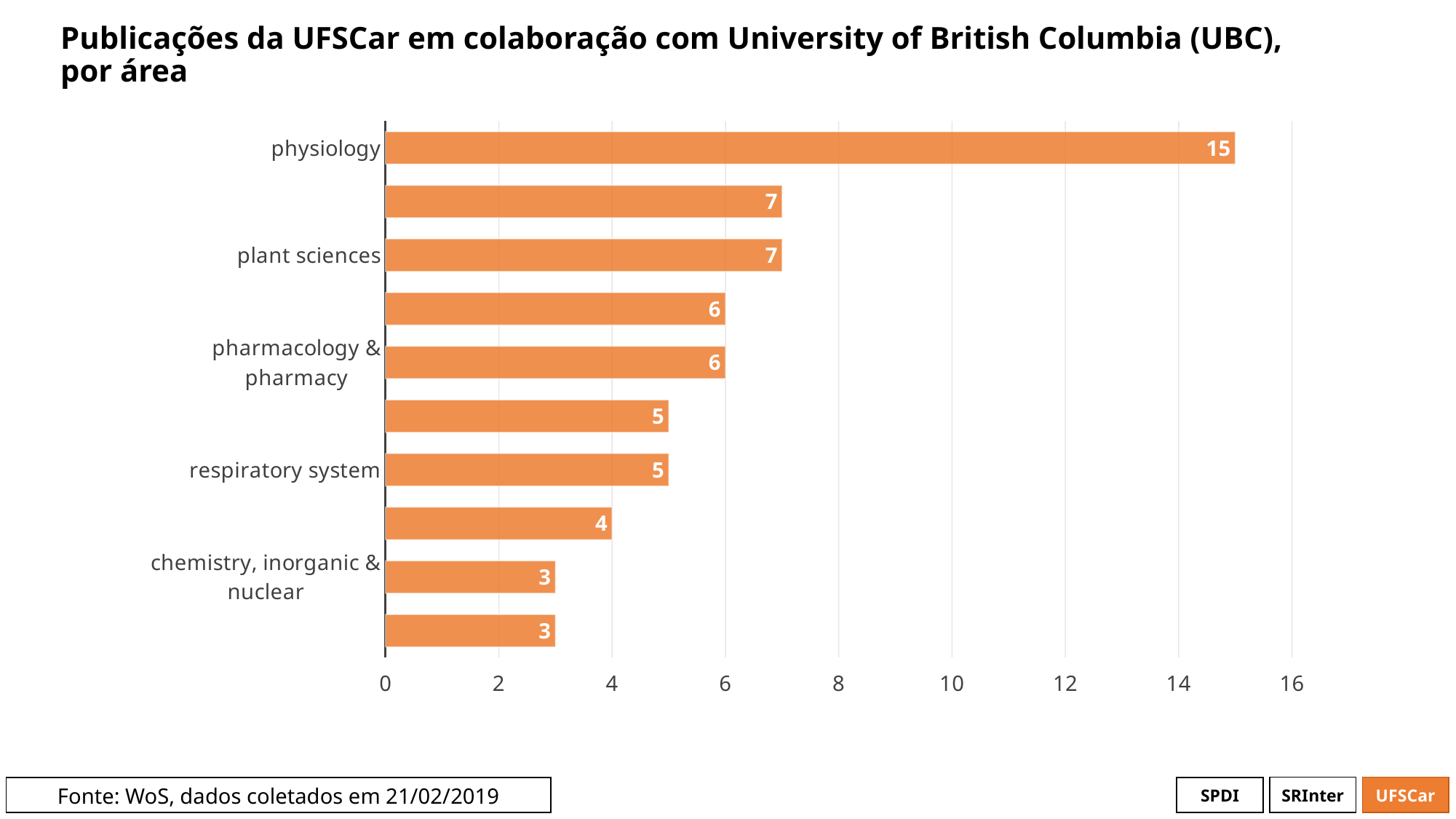
How many publications are shown for physiology? 15 What is the source of the data cited on the slide? WoS, dados coletados em 21/02/2019 Which is larger, the value for pharmacology & pharmacy or the value for respiratory system? pharmacology & pharmacy Which area has the highest number of publications? physiology What is the value for pharmacology & pharmacy? 6 What is the value for respiratory system? 5 How many bars are plotted in the chart? 10 What is the value for plant sciences? 7 What is the difference between the values for physiology and plant sciences? 8 What type of chart is shown on the slide? bar chart Is the value for physiology greater or less than 14? greater What is the value for chemistry, inorganic & nuclear? 3